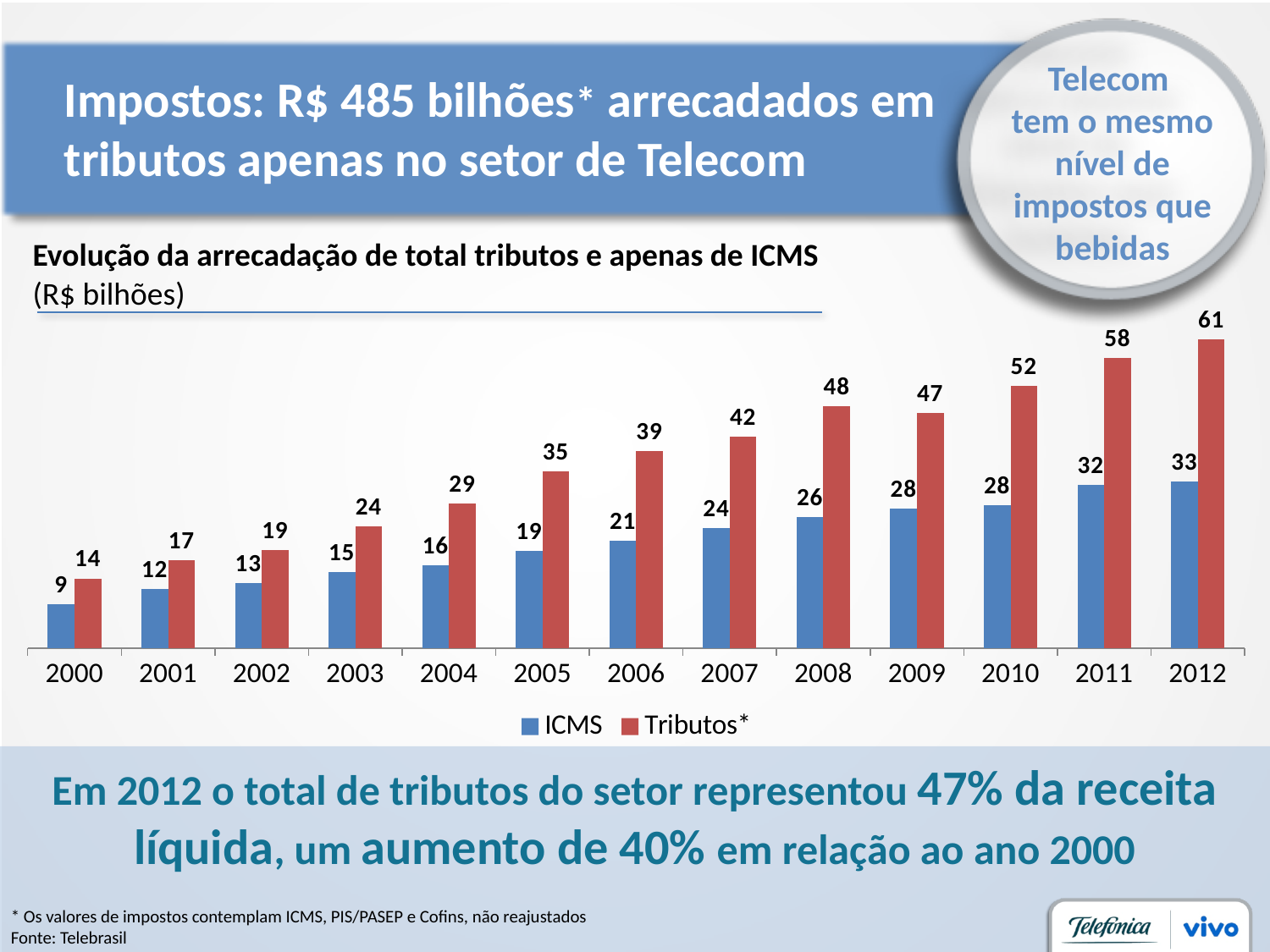
Which year has the lowest ICMS value? 2000 What is the Tributos* value for 2008? 48 How many series does the legend list? 2 Which year has the highest Tributos* value? 2012 What is the difference between the Tributos* value and the ICMS value in 2012? 28 How many years are shown on the x axis? 13 What kind of chart is shown on the slide? bar chart What colour are the ICMS bars? blue Do the Tributos* values generally rise or fall from 2000 to 2012? rise Which is larger, the Tributos* value for 2009 or the Tributos* value for 2010? 2010 What is the ICMS value for 2005? 19 What is the ICMS value for 2012? 33